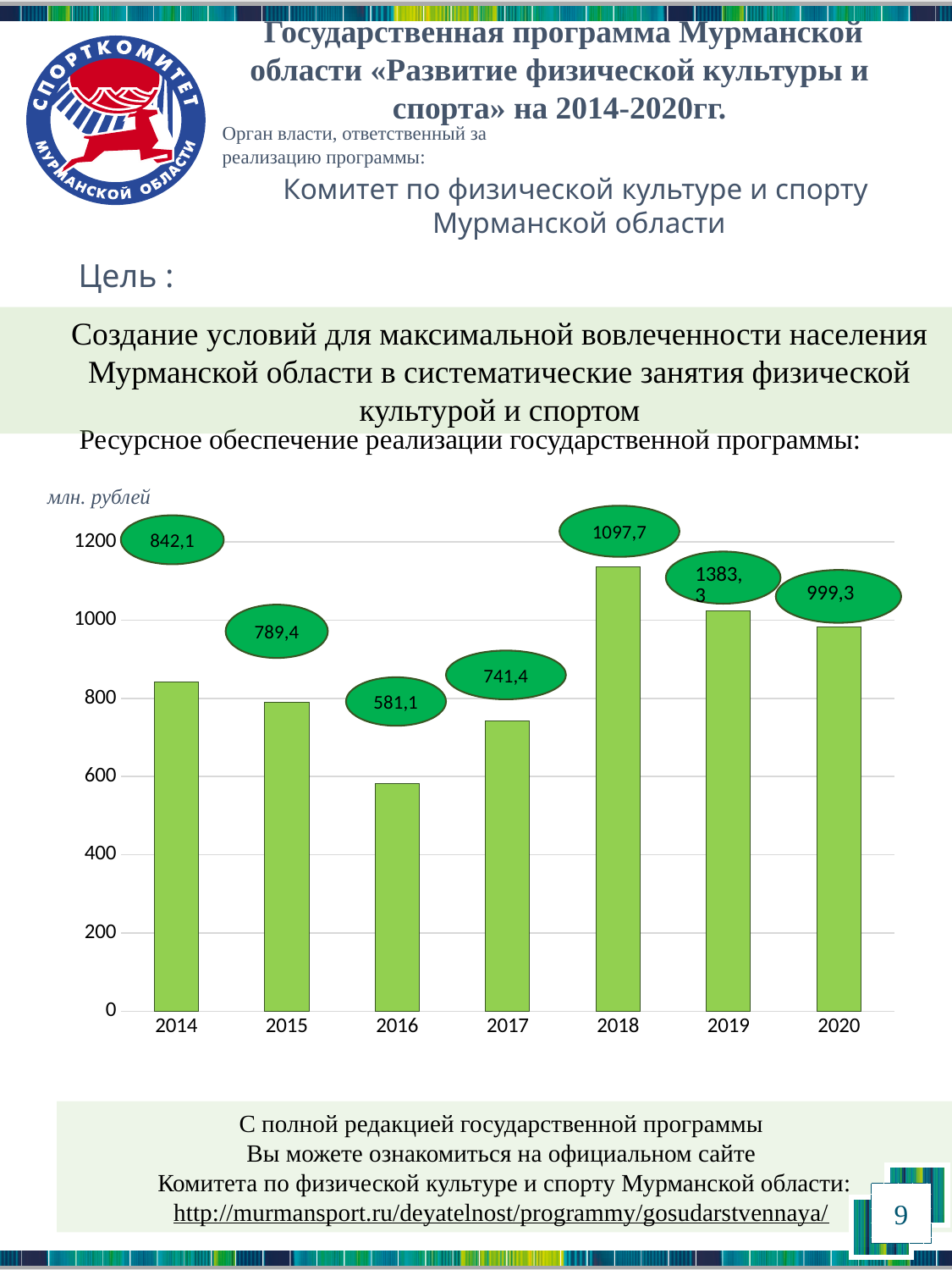
What is the value for 2014? 842,1 What is the difference between the values for 2014 and 2015? 52,7 Which year has the lowest value? 2016 Which is larger, the value for 2014 or the value for 2015? 2014 What is the value for 2016? 581,1 Do the values rise or fall from 2014 to 2016? fall Is the value for 2016 greater or less than 600? less What kind of chart is shown on the slide? bar chart How many years are shown on the x axis? 7